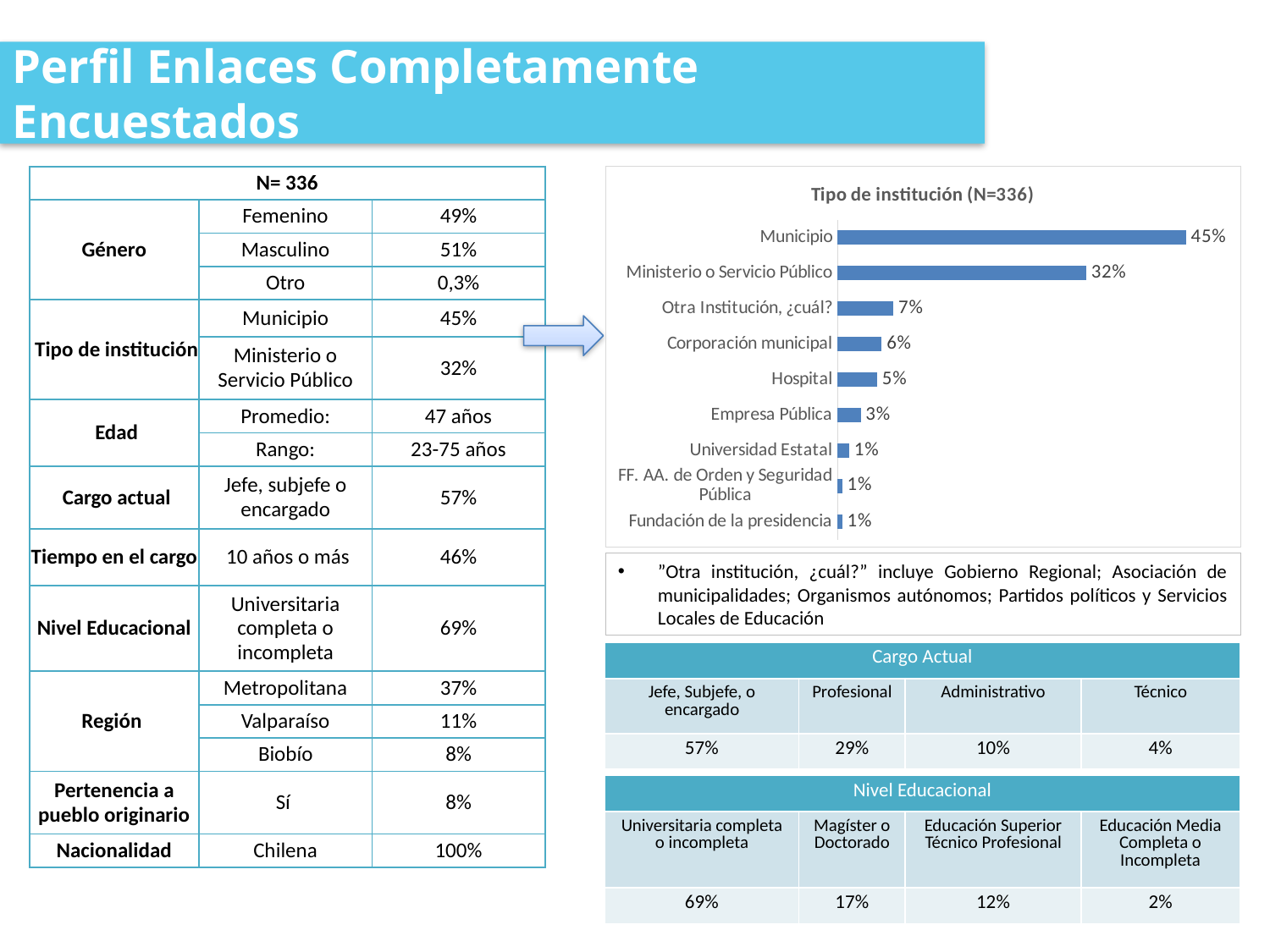
In the 'Tipo de institución (N=336)' chart, what is the value for Corporación municipal? 6% How many categories are shown in the 'Tipo de institución (N=336)' chart? 9 In the 'Tipo de institución (N=336)' chart, what is the value for Municipio? 45% In the 'Tipo de institución (N=336)' chart, which is larger: Hospital or Empresa Pública? Hospital In the 'Tipo de institución (N=336)' chart, which is larger: Otra Institución, ¿cuál? or Corporación municipal? Otra Institución, ¿cuál? In the 'Tipo de institución (N=336)' chart, what is the difference between Municipio and Ministerio o Servicio Público? 13% In the 'Tipo de institución (N=336)' chart, what is the value for Ministerio o Servicio Público? 32% What is the title of the bar chart on the slide? Tipo de institución (N=336) In the 'Tipo de institución (N=336)' chart, what is the value for Hospital? 5% In the 'Tipo de institución (N=336)' chart, which category has the highest value? Municipio What type of chart is used to show 'Tipo de institución (N=336)'? bar chart In the 'Tipo de institución (N=336)' chart, what is the value for Empresa Pública? 3%